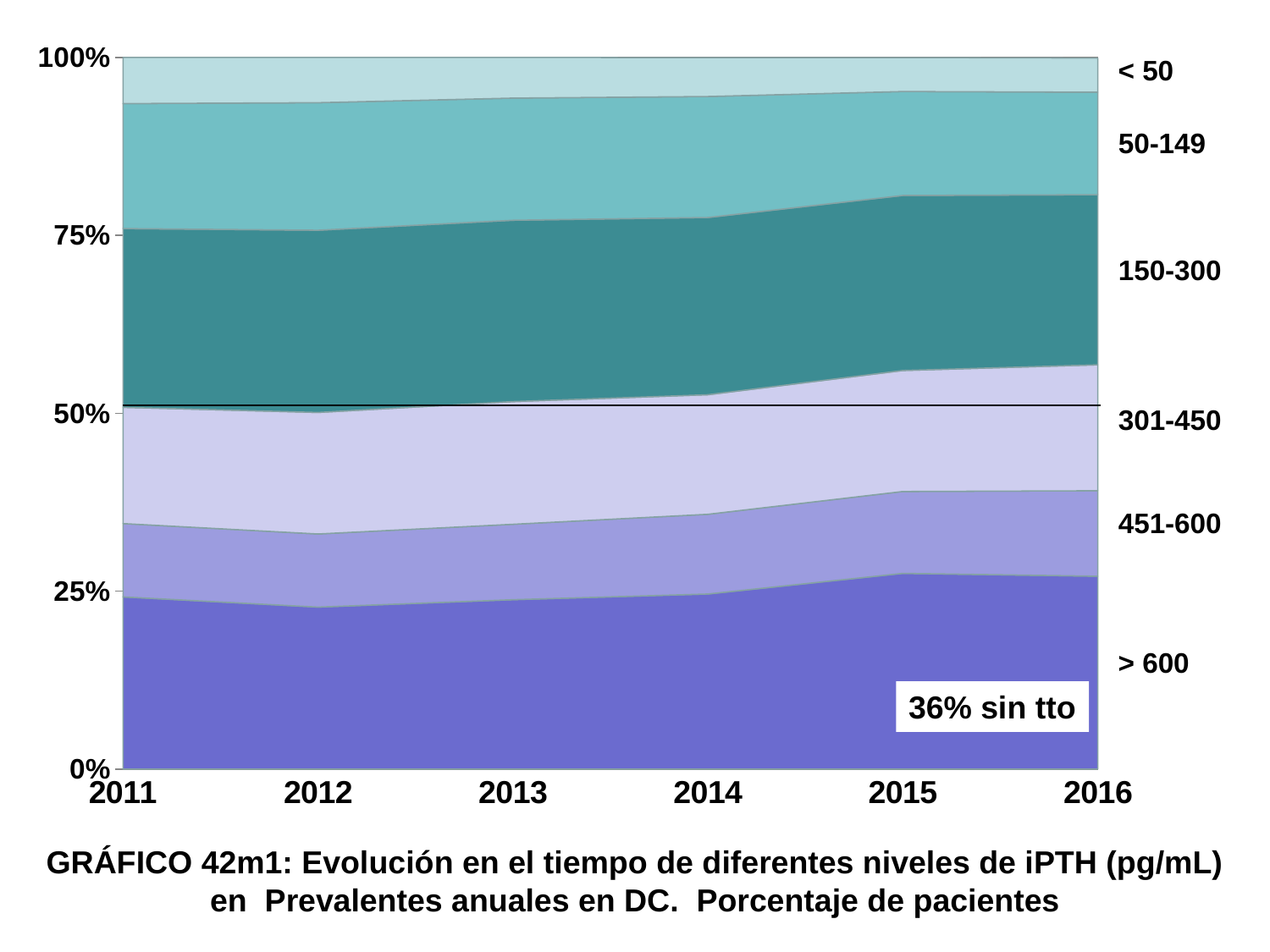
How many iPTH level categories (series) are labelled on the right of the chart? 6 What percentage of patients is stated in the text box inside the chart as being without treatment (sin tto)? 36% Is the share of patients with iPTH > 600 in 2016 greater or less than 25%? greater Is the share of patients with iPTH > 600 in 2012 greater or less than 25%? less How many years are shown along the x axis of the chart? 6 Which iPTH level category forms the top band of the chart? < 50 What kind of chart is shown on the slide? Stacked area chart Is the share of patients with iPTH > 600 in 2011 greater or less than 25%? less Which iPTH level category forms the bottom band of the chart? > 600 Is the share of patients with iPTH > 600 larger in 2015 or in 2012? 2015 Does the share of patients with iPTH > 600 rise or fall overall from 2011 to 2016? rise In which year is the share of patients with iPTH > 600 lowest? 2012